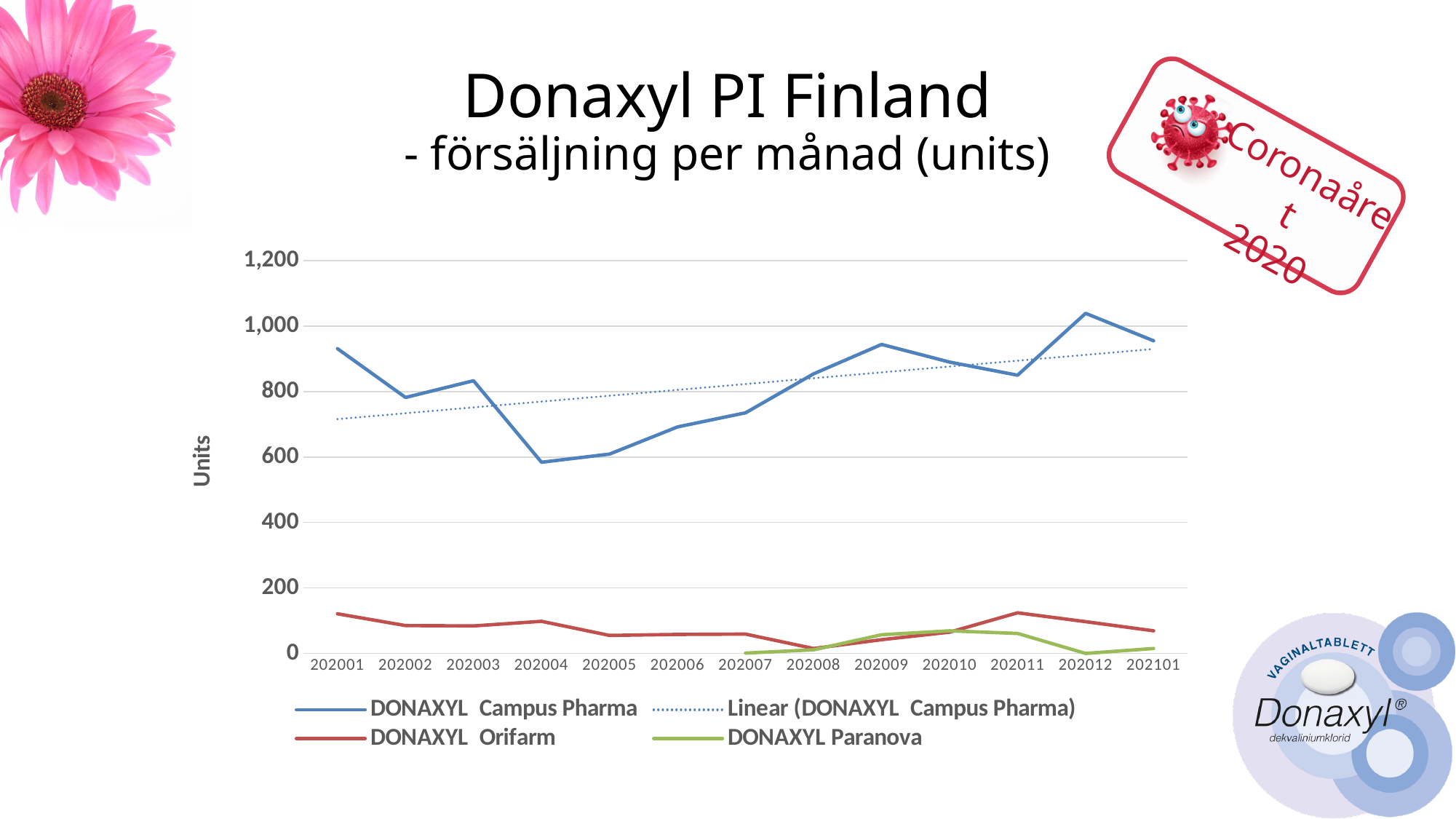
Is the value for DONAXYL Campus Pharma in 202004 greater or less than 600? less Is the value for DONAXYL Campus Pharma in 202012 greater or less than 1,000? greater Which series is drawn with a green line in the chart? DONAXYL Paranova Is the value for DONAXYL Campus Pharma in 202001 greater or less than 800? greater What kind of chart is shown on the slide? line chart How many series does the chart legend list? 4 What is the label on the vertical axis of the chart? Units Which series has the larger value in 202009, DONAXYL Campus Pharma or DONAXYL Orifarm? DONAXYL Campus Pharma Does the dotted linear trendline for DONAXYL Campus Pharma rise or fall from 202001 to 202101? rise In which month does the DONAXYL Campus Pharma series reach its highest value? 202012 How many months are shown along the x axis of the chart? 13